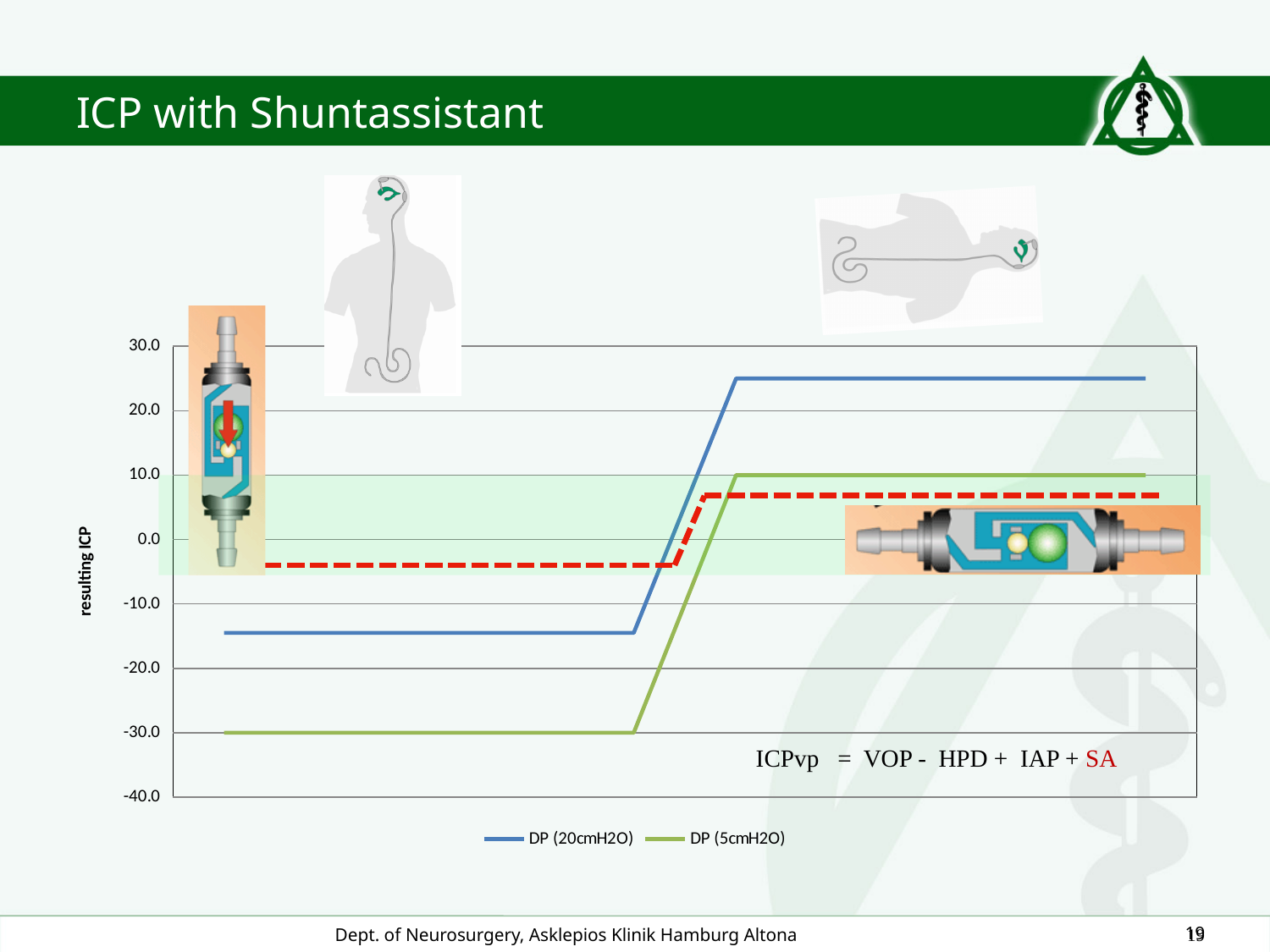
Do the values of the DP (5cmH2O) series rise or fall from left to right along the x axis? rise What is the final value of the DP (5cmH2O) series on the right side of the chart? 10.0 Do the values of the DP (20cmH2O) series rise or fall from left to right along the x axis? rise What is the starting value of the DP (5cmH2O) series on the left side of the chart? -30.0 What is the label of the vertical axis of the chart? resulting ICP On the left side of the chart, which series has the lower value, DP (20cmH2O) or DP (5cmH2O)? DP (5cmH2O) On the right side of the chart, which series has the higher value, DP (20cmH2O) or DP (5cmH2O)? DP (20cmH2O) What kind of chart is shown on the slide? line chart Is the starting value of the DP (20cmH2O) series on the left side of the chart greater or less than -10.0? less Is the final value of the DP (20cmH2O) series on the right side of the chart greater or less than 20.0? greater How many series does the chart legend list? 2 What are the two series named in the chart legend? DP (20cmH2O) and DP (5cmH2O)